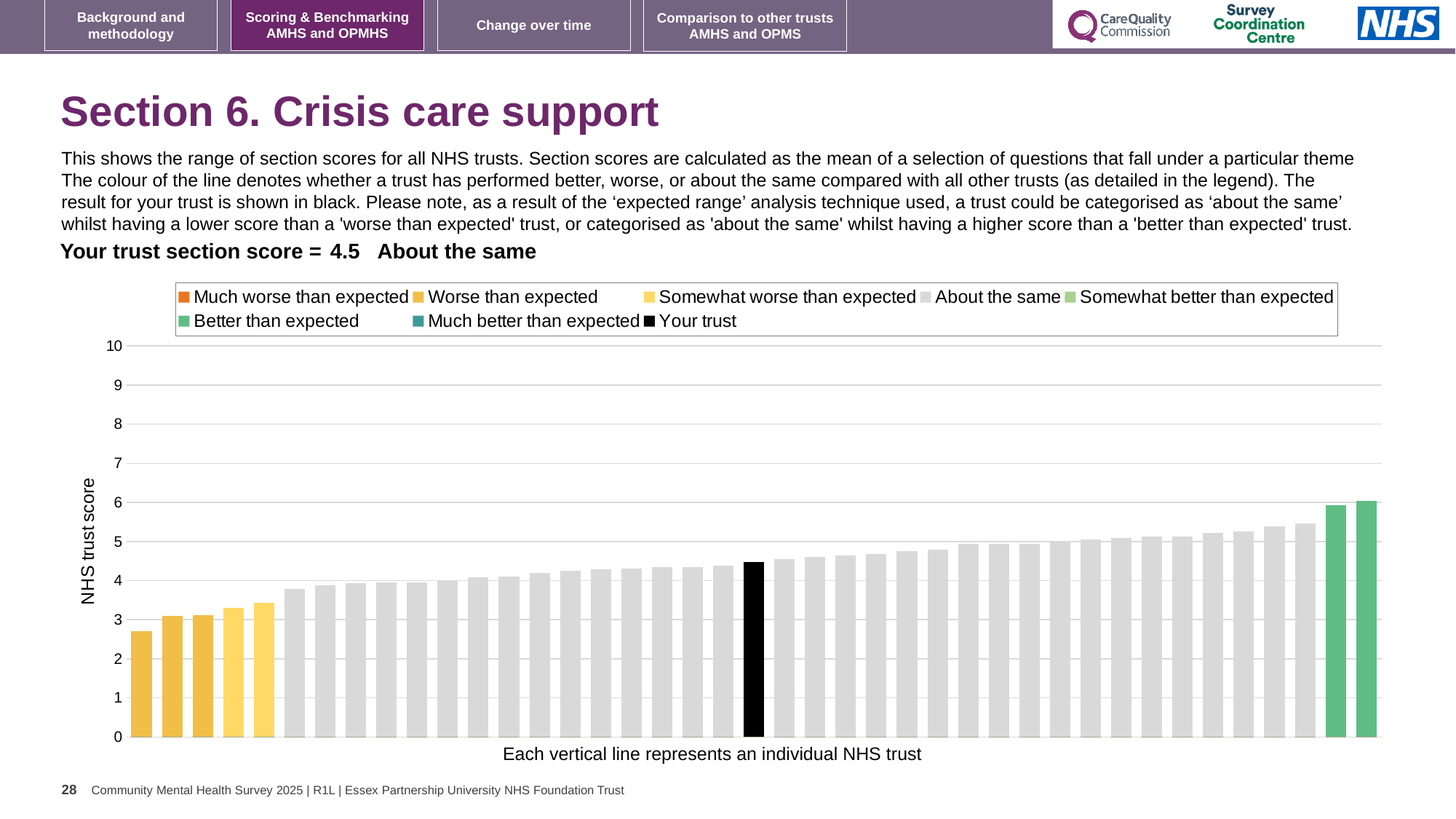
Is the value of the rightmost (highest) bar greater or less than 7? less What is your trust's section score shown on the slide? 4.5 Which legend category does the highest bar on the chart belong to? Better than expected Is the value for your trust (the black bar) greater or less than 4? greater How many bars are coloured green (Better than expected)? 2 What is the label on the vertical axis of the chart? NHS trust score Which legend category does the lowest bar on the chart belong to? Worse than expected Is the value of the leftmost (lowest) bar greater or less than 3? less Is your trust's bar higher or lower than the leftmost bar? higher Do the bar values rise or fall from left to right along the x axis? rise What type of chart is shown on the slide? bar chart How many entries does the chart legend list? 8